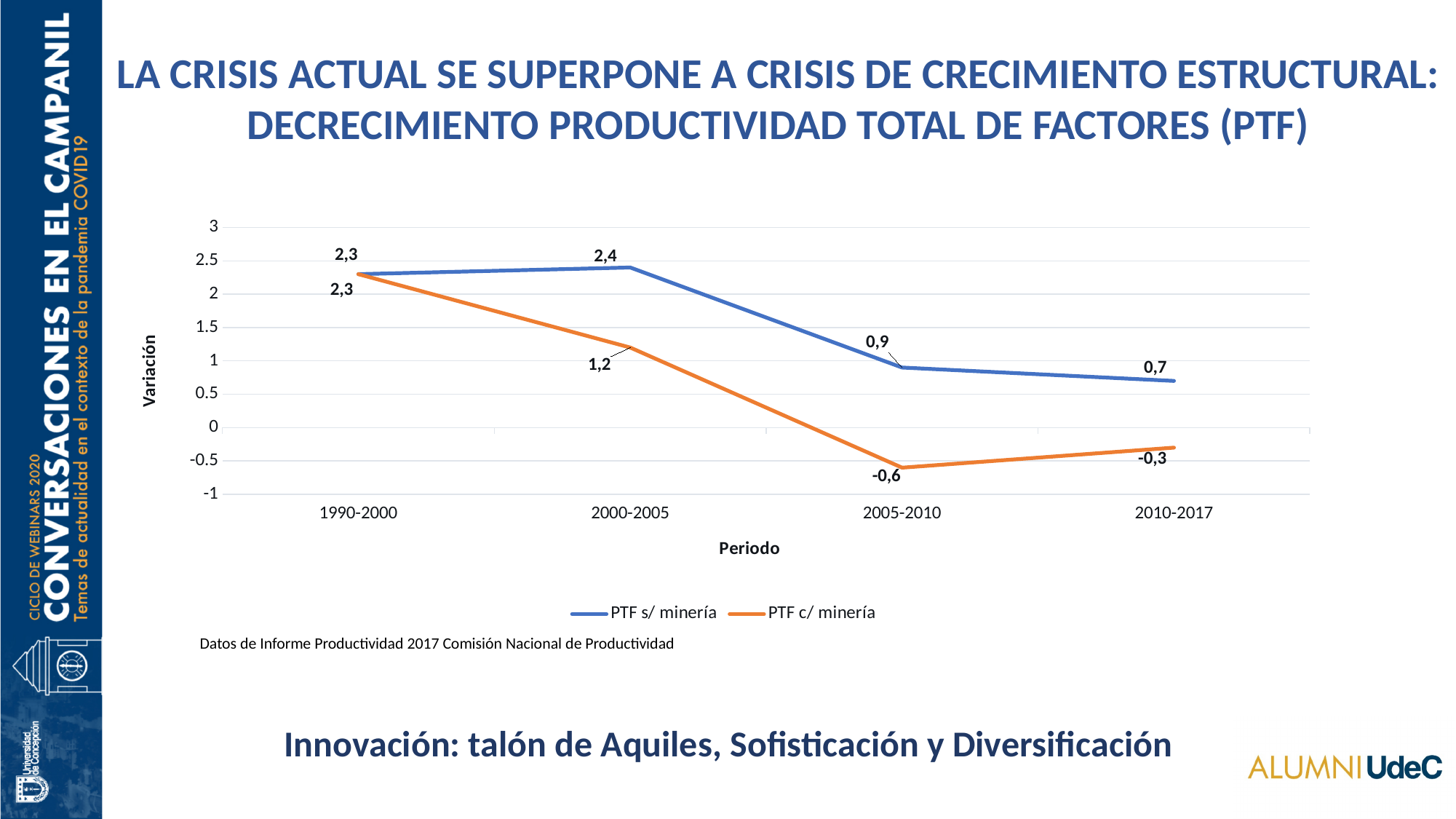
In which period is PTF s/ minería highest? 2000-2005 What is the difference between PTF s/ minería and PTF c/ minería in 2005-2010? 1,5 What is the value of PTF c/ minería for 2010-2017? -0,3 How many series does the legend list? 2 Which series has the larger value in 2000-2005, PTF s/ minería or PTF c/ minería? PTF s/ minería What is the label of the y axis? Variación What is the value of PTF s/ minería for 2000-2005? 2,4 In which period is PTF c/ minería lowest? 2005-2010 How many periods are shown on the x axis? 4 Does PTF c/ minería rise or fall from 1990-2000 to 2005-2010? Fall What type of chart is shown on the slide? Line chart What is the value of PTF c/ minería for 2005-2010? -0,6